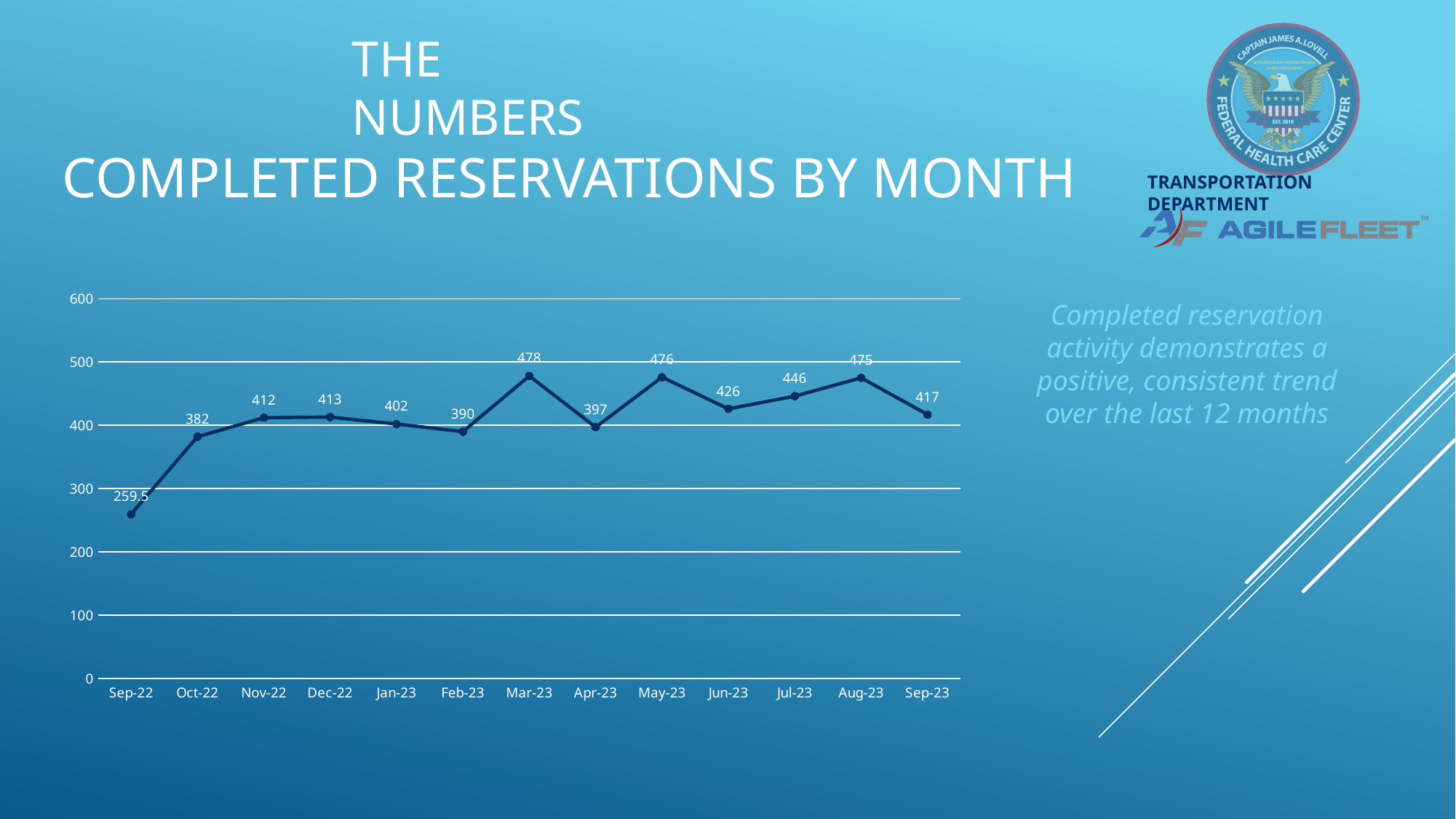
What is the difference between the values for Mar-23 and Apr-23? 81 Does the value rise or fall from Sep-22 to Oct-22? rise How many months are plotted on the chart? 13 Is the value for Feb-23 greater or less than 400? less What type of chart is shown on the slide? line chart What is the value for Sep-22? 259.5 What is the title of the chart on the slide? Completed Reservations by Month What is the value for Mar-23? 478 Which month has the highest number of completed reservations? Mar-23 Which month has the lowest number of completed reservations? Sep-22 What is the value for Jul-23? 446 Which is larger, the value for Jun-23 or the value for Sep-23? Jun-23